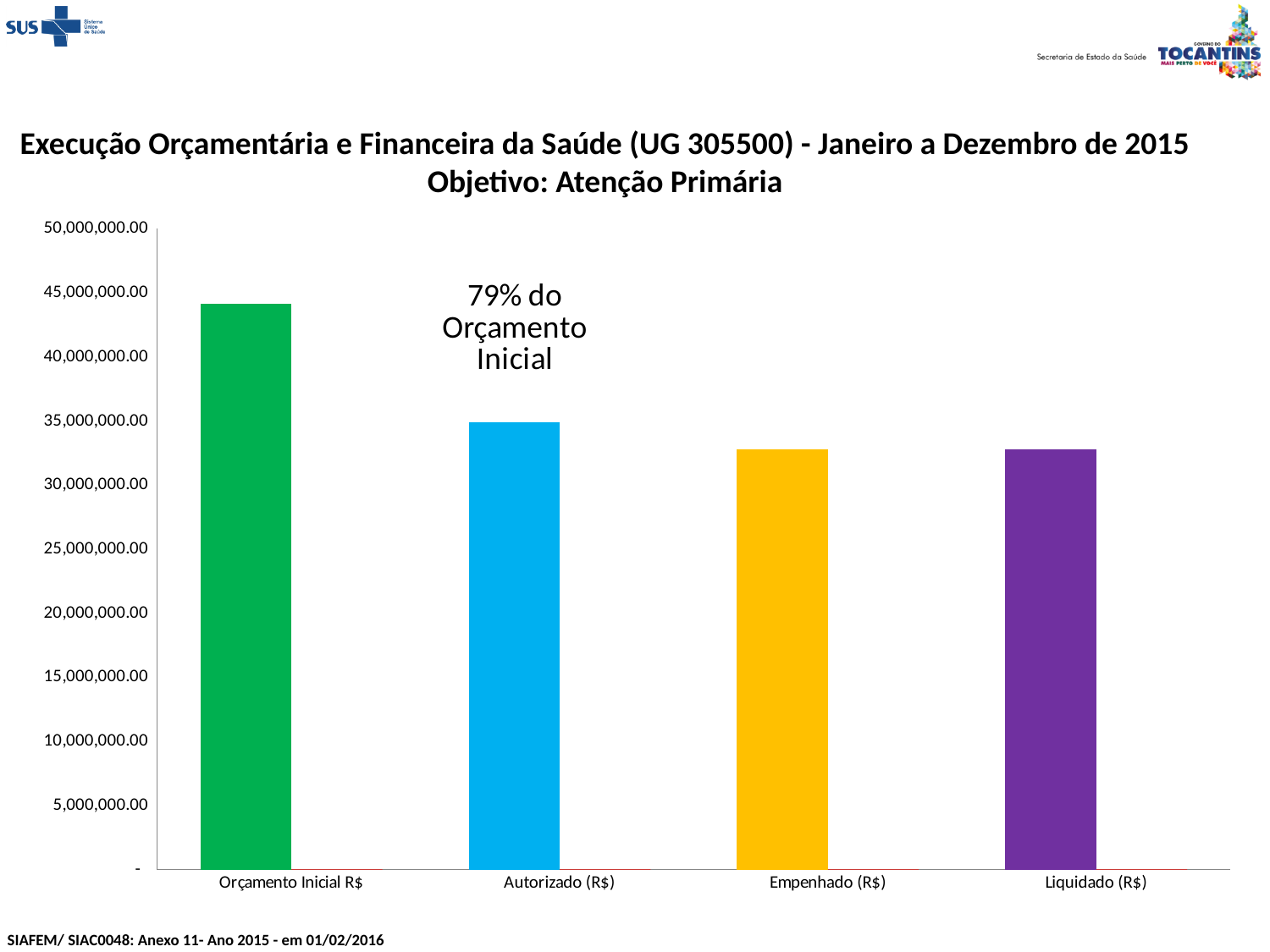
Which is larger, the value for Orçamento Inicial R$ or the value for Autorizado (R$)? Orçamento Inicial R$ What objective is named in the chart title? Atenção Primária Is the value for Liquidado (R$) greater or less than 35,000,000.00? less What percentage of the Orçamento Inicial does the annotation on the chart state? 79% How many bars are plotted in the chart? 4 Is the value for Empenhado (R$) greater or less than 30,000,000.00? greater Do the values generally rise or fall from left to right across the categories? fall Is the value for Orçamento Inicial R$ greater or less than 40,000,000.00? greater What kind of chart is shown on the slide? bar chart Which category has the highest value? Orçamento Inicial R$ Which is larger, the value for Autorizado (R$) or the value for Empenhado (R$)? Autorizado (R$)